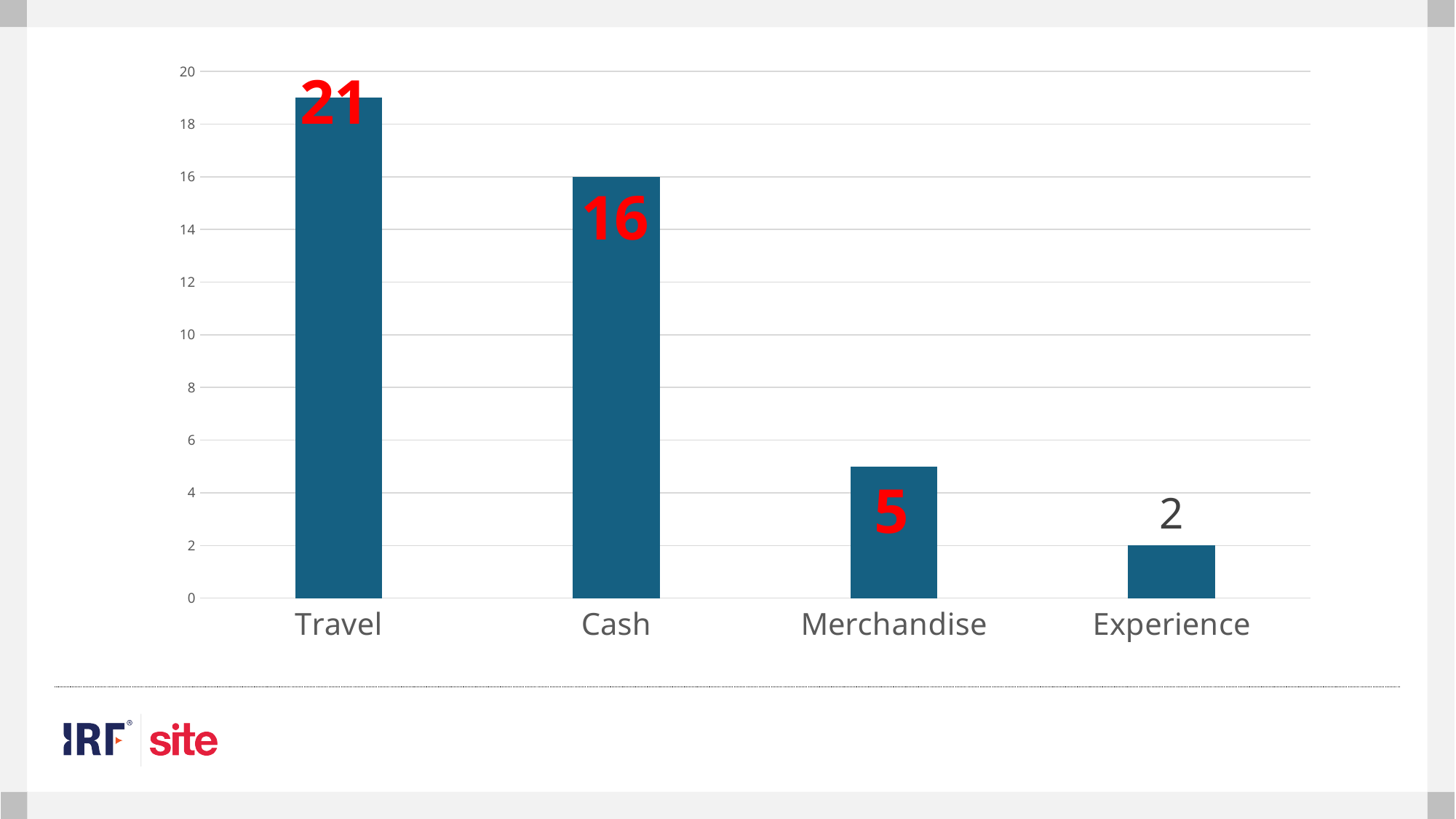
Which is larger, the value for Merchandise or the value for Experience? Merchandise Which category has the highest value? Travel Which category has the lowest value? Experience What is the difference between the values for Cash and Merchandise? 11 Do the values rise or fall from left to right along the x axis? Fall What is the value for Cash? 16 How many categories are shown on the x axis? 4 Is the value for Cash greater or less than 10? greater What kind of chart is shown on the slide? Bar chart What is the value for Experience? 2 What is the value for Merchandise? 5